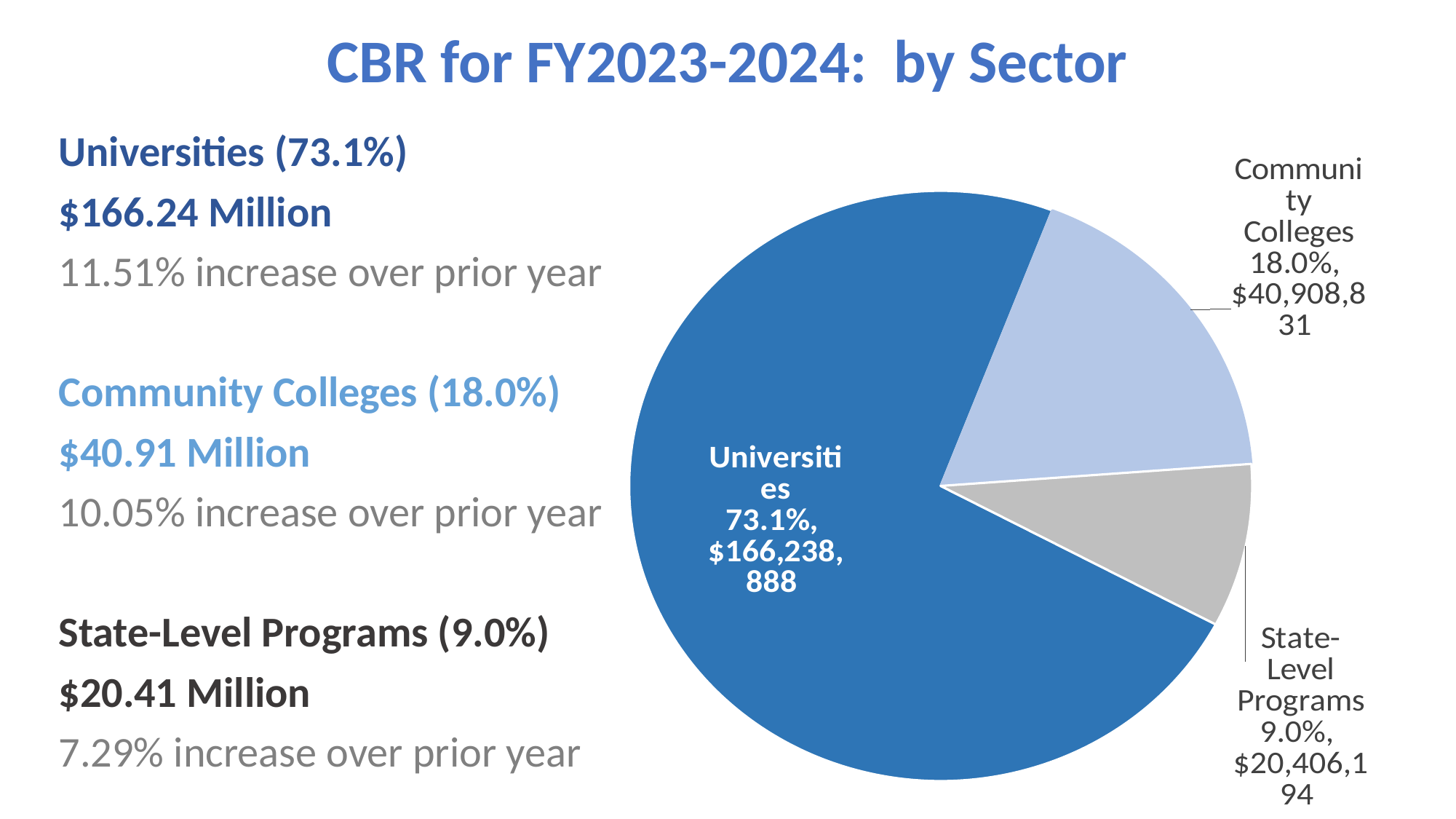
Which slice is larger, Community Colleges or State-Level Programs? Community Colleges Which sector has the largest slice of the pie? Universities What kind of chart is shown on the slide? Pie chart What share of the pie does the Universities slice represent? 73.1% What share of the pie does the Community Colleges slice represent? 18.0% What is the difference in dollar value between the Community Colleges slice and the State-Level Programs slice? $20,502,637 What dollar value is labelled on the State-Level Programs slice? $20,406,194 How many slices does the pie chart have? 3 What dollar value is labelled on the Universities slice? $166,238,888 What share of the pie does the State-Level Programs slice represent? 9.0% Which sector has the smallest slice of the pie? State-Level Programs What dollar value is labelled on the Community Colleges slice? $40,908,831